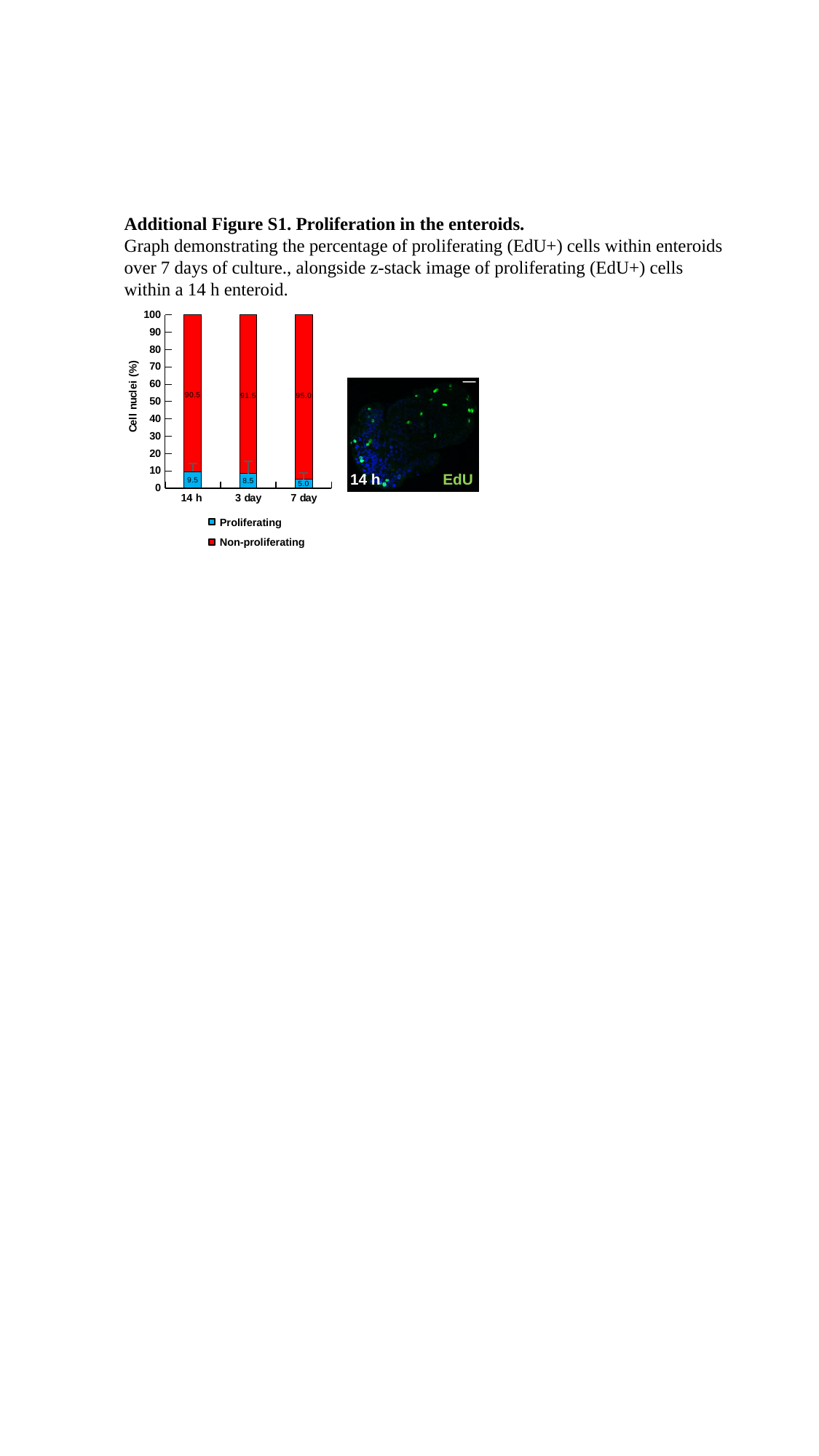
What is the Proliferating value for 7 day? 5.0 Which is larger, the Non-proliferating value for 14 h or for 7 day? 7 day What is the Proliferating value for 14 h? 9.5 How many categories are shown on the x axis? 3 What is the Non-proliferating value for 3 day? 91.5 Which category has the highest Proliferating value? 14 h Which category has the lowest Proliferating value? 7 day What is the Non-proliferating value for 7 day? 95.0 What is the difference between the Proliferating values for 14 h and 7 day? 4.5 What is the total of the stacked bar for 3 day? 100 How many series does the legend list? 2 What kind of chart is shown? Stacked bar chart